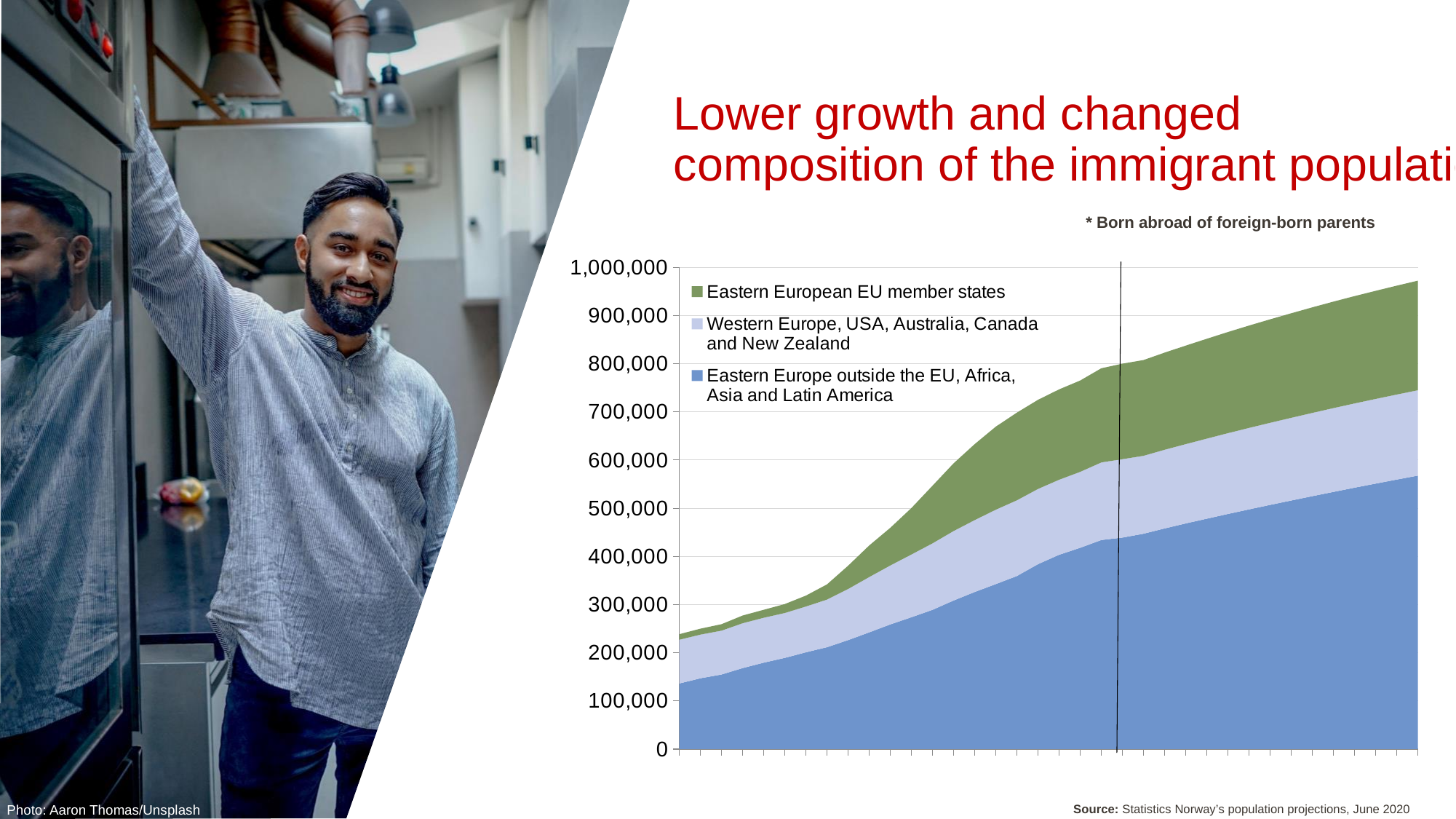
What kind of chart is shown on the slide? Stacked area chart At the right end of the chart, is the band for Eastern Europe outside the EU, Africa, Asia and Latin America larger or smaller than the band for Eastern European EU member states? Larger Which series is plotted at the bottom of the stacked area chart? Eastern Europe outside the EU, Africa, Asia and Latin America At the right end of the chart, which series accounts for the largest share of the stacked total? Eastern Europe outside the EU, Africa, Asia and Latin America What is the highest value labelled on the chart's vertical axis? 1,000,000 Does the total immigrant population rise or fall from left to right along the x axis? Rise How many series does the chart's legend list? 3 Is the value of the bottom series (Eastern Europe outside the EU, Africa, Asia and Latin America) at the right end of the chart greater or less than 500,000? greater Is the value of the bottom series (Eastern Europe outside the EU, Africa, Asia and Latin America) at the left end of the chart greater or less than 200,000? less Is the total stacked value at the left end of the chart greater or less than 300,000? less Which series is shown in green in the chart? Eastern European EU member states